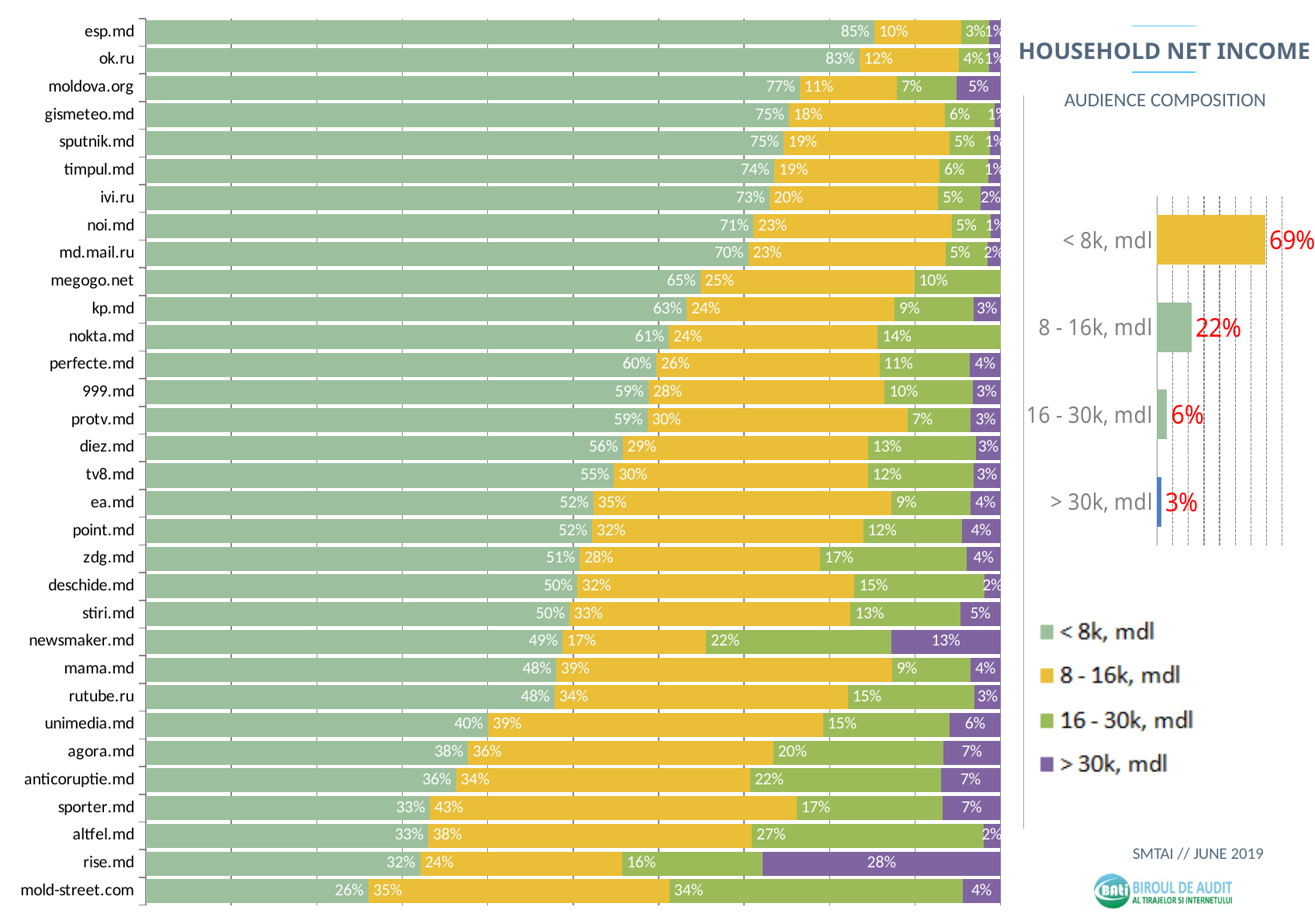
In the left-hand stacked bar chart, what is the '> 30k, mdl' share for rise.md? 28% In the left-hand stacked bar chart, which website has the highest '< 8k, mdl' share? esp.md How many series does the legend of the left-hand stacked bar chart list? 4 In the right-hand chart (Household Net Income audience composition), how many income bands are shown? 4 In the left-hand stacked bar chart, what is the '< 8k, mdl' share for esp.md? 85% In the left-hand stacked bar chart, which has the larger '8 - 16k, mdl' share, sporter.md or agora.md? sporter.md In the right-hand chart (Household Net Income audience composition), what is the difference between the '< 8k, mdl' and '8 - 16k, mdl' values? 47% In the left-hand stacked bar chart, what is the '16 - 30k, mdl' share for mold-street.com? 34% In the right-hand chart (Household Net Income audience composition), what is the value for '< 8k, mdl'? 69% In the left-hand stacked bar chart, which website has the lowest '< 8k, mdl' share? mold-street.com In the right-hand chart (Household Net Income audience composition), which income band has the lowest share? > 30k, mdl In the left-hand stacked bar chart, how many websites are listed? 32